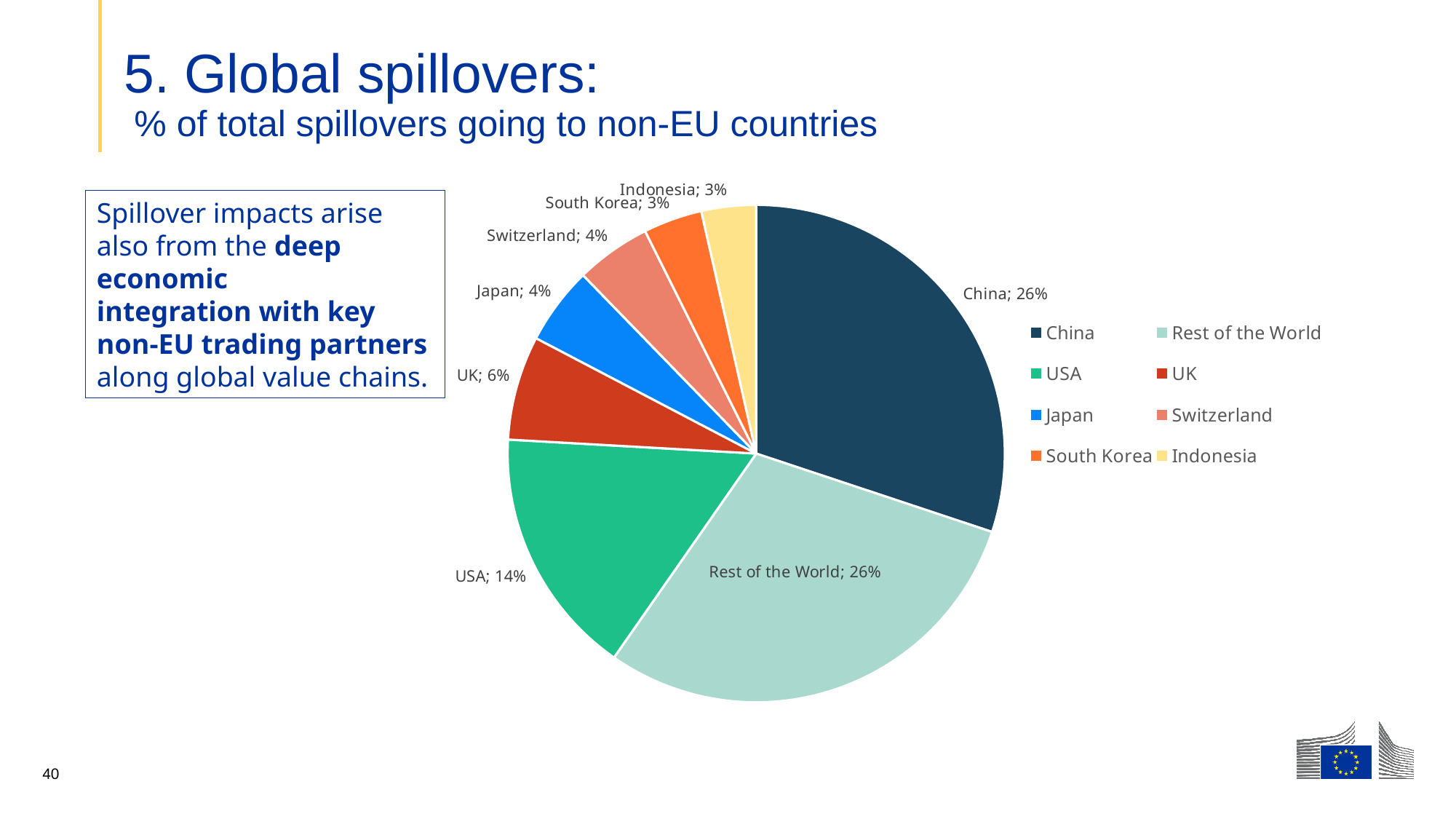
How many slices does the pie chart have? 8 What is the difference between the USA share and the UK share? 8% What share of total spillovers goes to Indonesia? 3% Which slice is the smallest among USA, UK and Japan? Japan What colour is the China slice in the pie chart? dark blue Which slice is larger, USA or UK? USA What share of total spillovers goes to Japan? 4% What share of total spillovers goes to the UK? 6% What share of total spillovers goes to China? 26% What share of total spillovers goes to the USA? 14% What type of chart is shown on the slide? pie chart How many entries does the legend list? 8